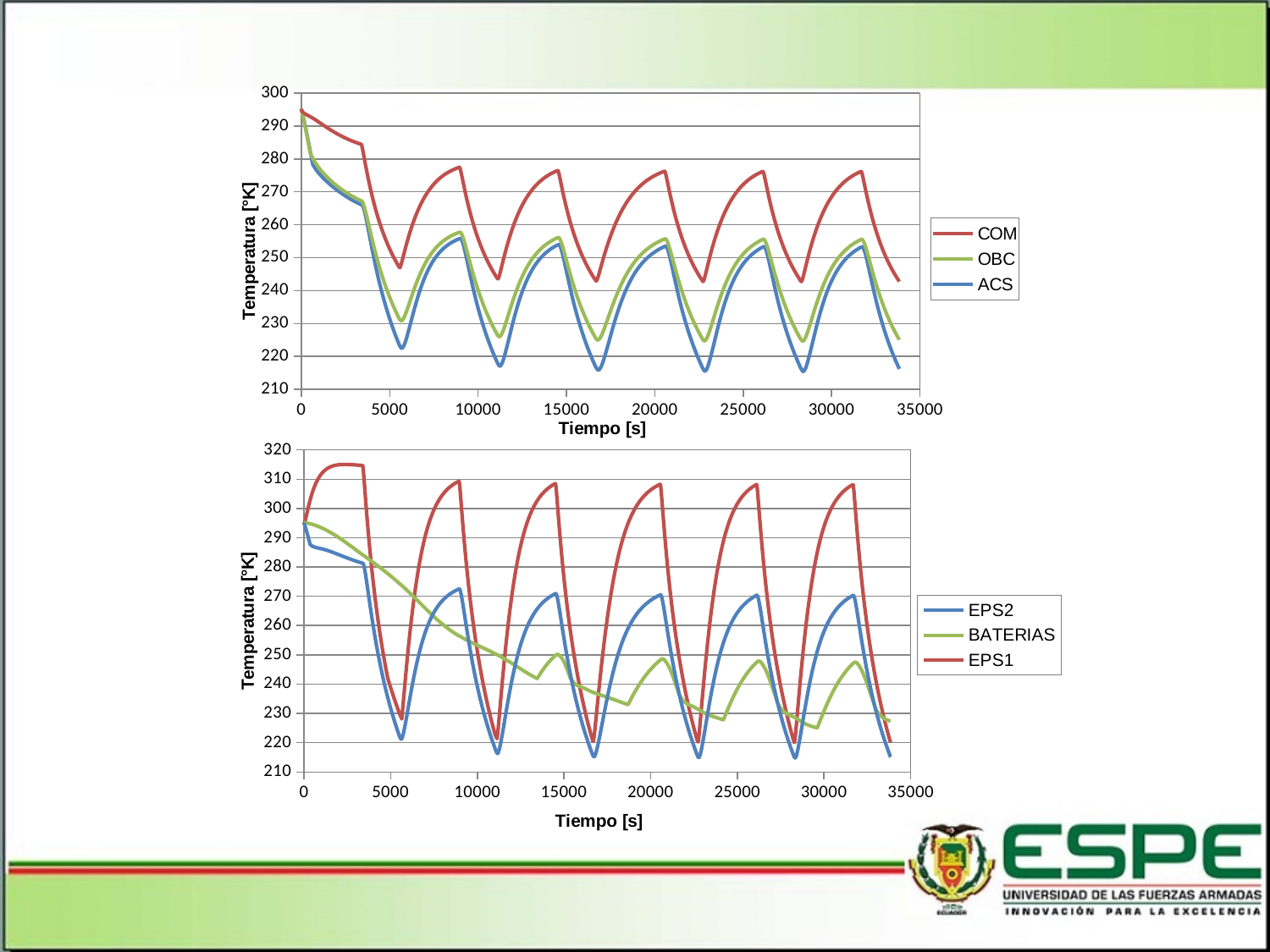
In the top chart, which series reaches the lowest temperatures? ACS In the bottom chart, which series reaches the highest temperatures? EPS1 In the top chart, is the lowest value reached by ACS greater or less than 220? less In the top chart, is the lowest value reached by COM greater or less than 230? greater How many series does the legend of the top chart list? 3 What kind of chart is the top chart on the slide? line chart How many series does the legend of the bottom chart list? 3 In the bottom chart, is the highest value reached by EPS1 greater or less than 300? greater What is the label of the x axis on the bottom chart? Tiempo [s] In the bottom chart, does the BATERIAS series rise or fall overall along the x axis? fall In the top chart, which series stays at the highest temperatures throughout? COM